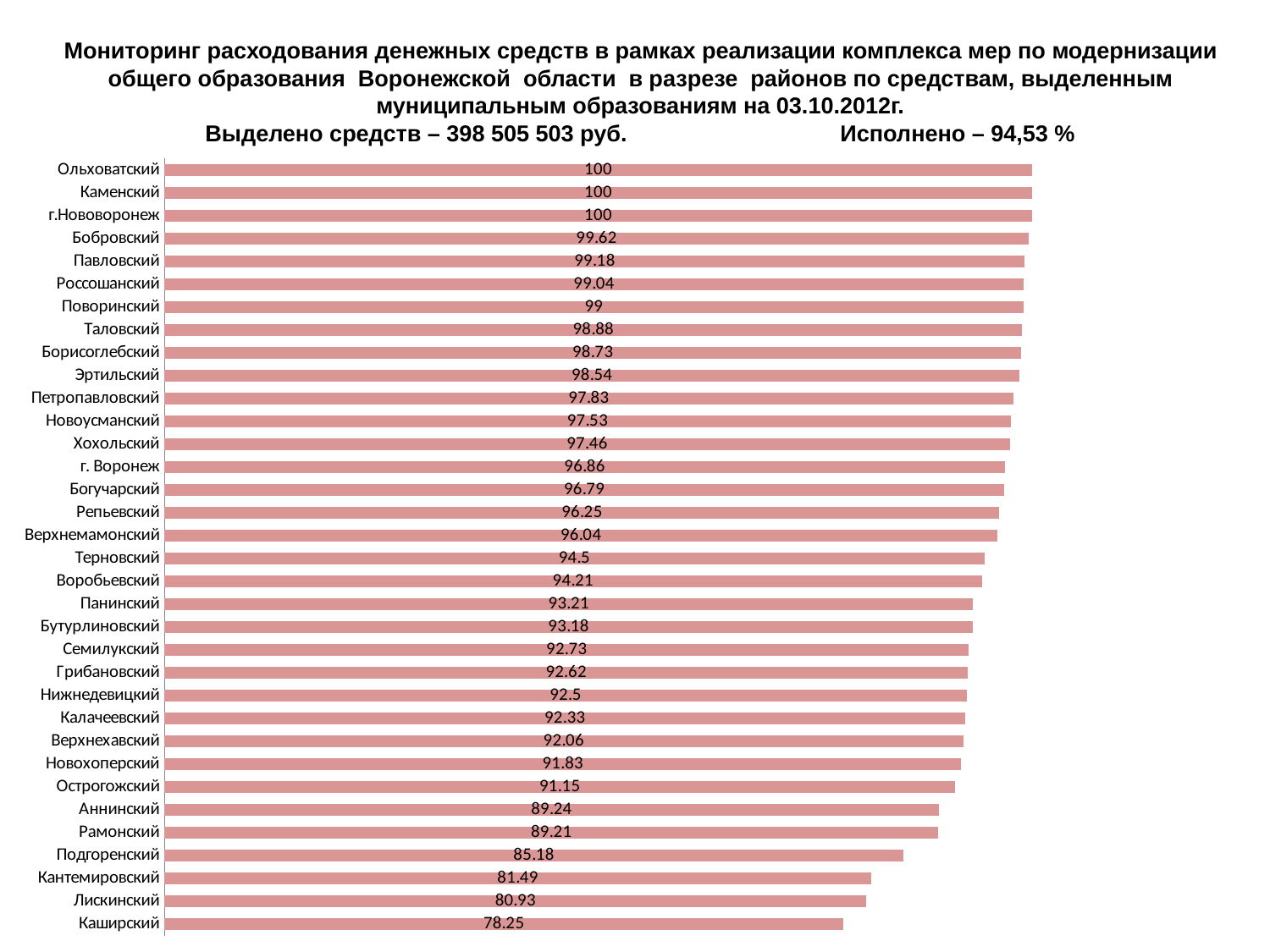
How many districts have a value of 100? 3 According to the slide header, what is the overall execution percentage (Исполнено)? 94,53 % What is the difference between the values for Ольховатский and Каширский? 21.75 What is the value shown for г. Воронеж? 96.86 What is the value shown for Каширский? 78.25 What is the value shown for Бобровский? 99.62 What is the value shown for Подгоренский? 85.18 What is the difference between the values for Кантемировский and Лискинский? 0.56 What kind of chart is shown on the slide? Bar chart Which district has the lowest value on the chart? Каширский How many districts (categories) are shown on the chart? 34 Which is larger, the value for Аннинский or the value for Подгоренский? Аннинский